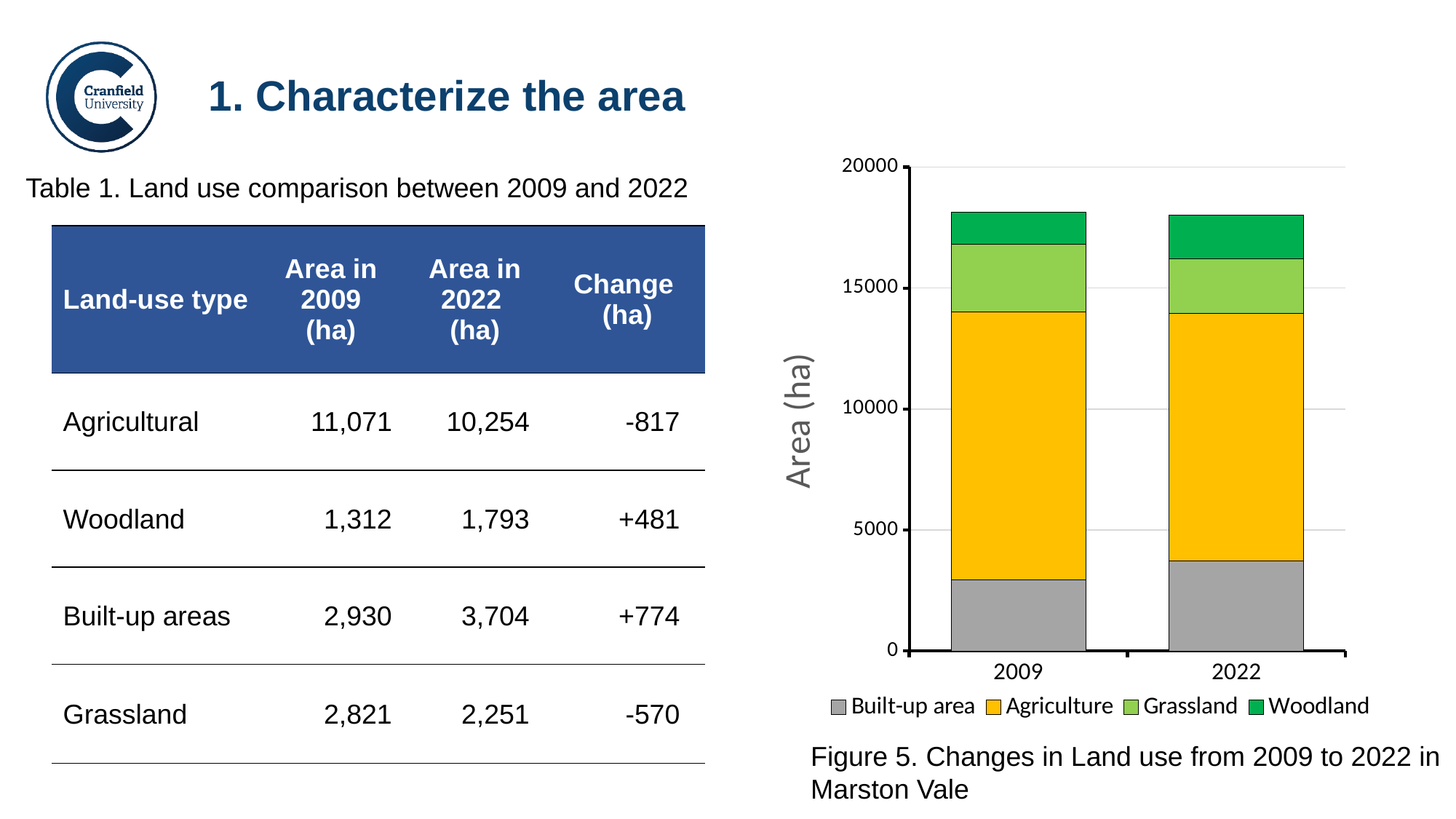
Is the Built-up area segment for 2009 greater or less than 5000? less How many years (bars) are shown on the x axis of the chart? 2 How many series does the chart legend list? 4 What kind of chart is Figure 5? stacked bar chart Which year has the larger Woodland segment, 2009 or 2022? 2022 Is the total height of the 2009 stacked bar greater or less than 15000? greater What is the label on the y axis of the chart? Area (ha) Is the total height of the 2022 stacked bar greater or less than 20000? less Which year has the larger Grassland segment, 2009 or 2022? 2009 Which series is shown in yellow in the chart? Agriculture Which year has the larger Built-up area segment, 2009 or 2022? 2022